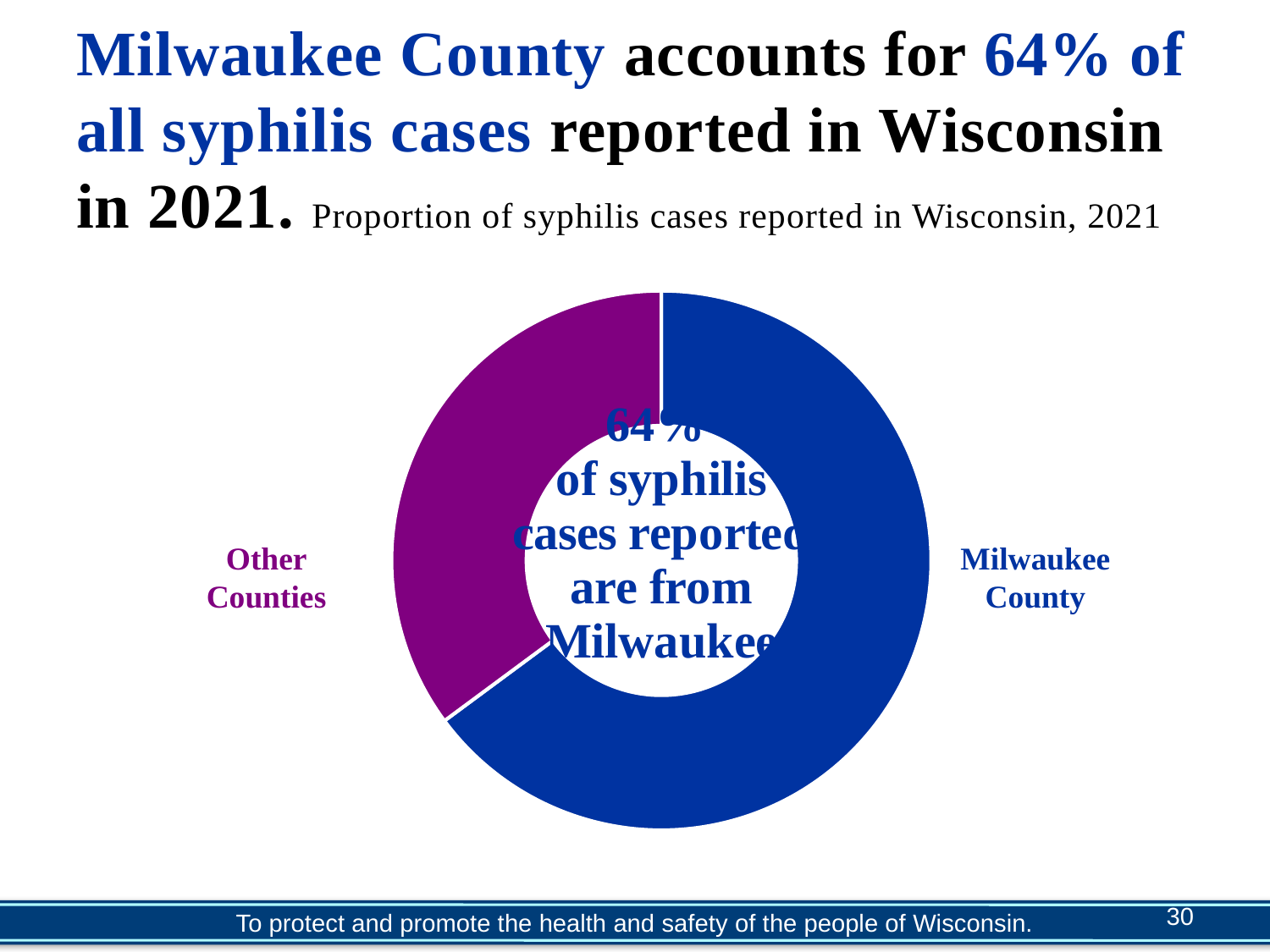
What kind of chart is shown on the slide? doughnut chart How many categories are shown in the pie chart? 2 Which category has the smallest slice of the pie? Other Counties Which slice is larger, Milwaukee County or Other Counties? Milwaukee County What year does the chart's data refer to? 2021 What colour is the Milwaukee County slice? blue Which category has the largest slice of the pie? Milwaukee County Is the share for Milwaukee County greater or less than 50%? greater What share of the pie do the Other Counties account for? 36% What share of syphilis cases reported in Wisconsin in 2021 is from Milwaukee County? 64% What is the title of the chart? Proportion of syphilis cases reported in Wisconsin, 2021